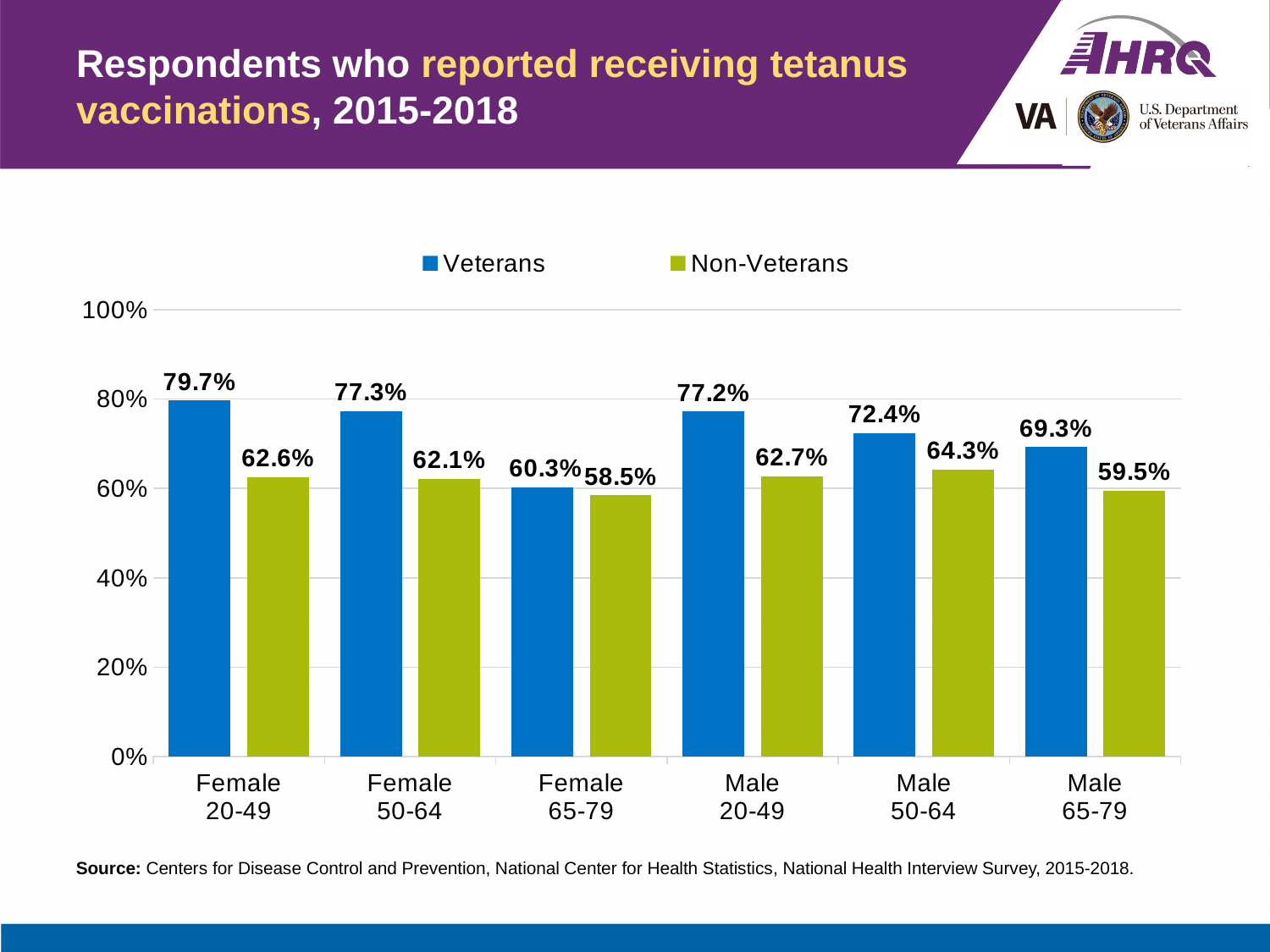
Which category has the lowest value for Non-Veterans? Female 65-79 Do the Veterans values rise or fall across the three Female age groups from 20-49 to 65-79? Fall Which colour represents Non-Veterans in the chart? Green What is the value for Non-Veterans in the Male 50-64 category? 64.3% How many categories are shown on the x axis? 6 Which category has the highest value for Veterans? Female 20-49 What is the difference between Veterans and Non-Veterans in the Male 20-49 category? 14.5% Is the Veterans value for Male 65-79 greater or less than 60%? greater How many series does the legend list? 2 Which is larger: the Veterans value for Female 65-79 or the Non-Veterans value for Female 65-79? Veterans (60.3%) What kind of chart is shown on the slide? Bar chart What percentage of Veterans aged Female 20-49 reported receiving tetanus vaccinations? 79.7%